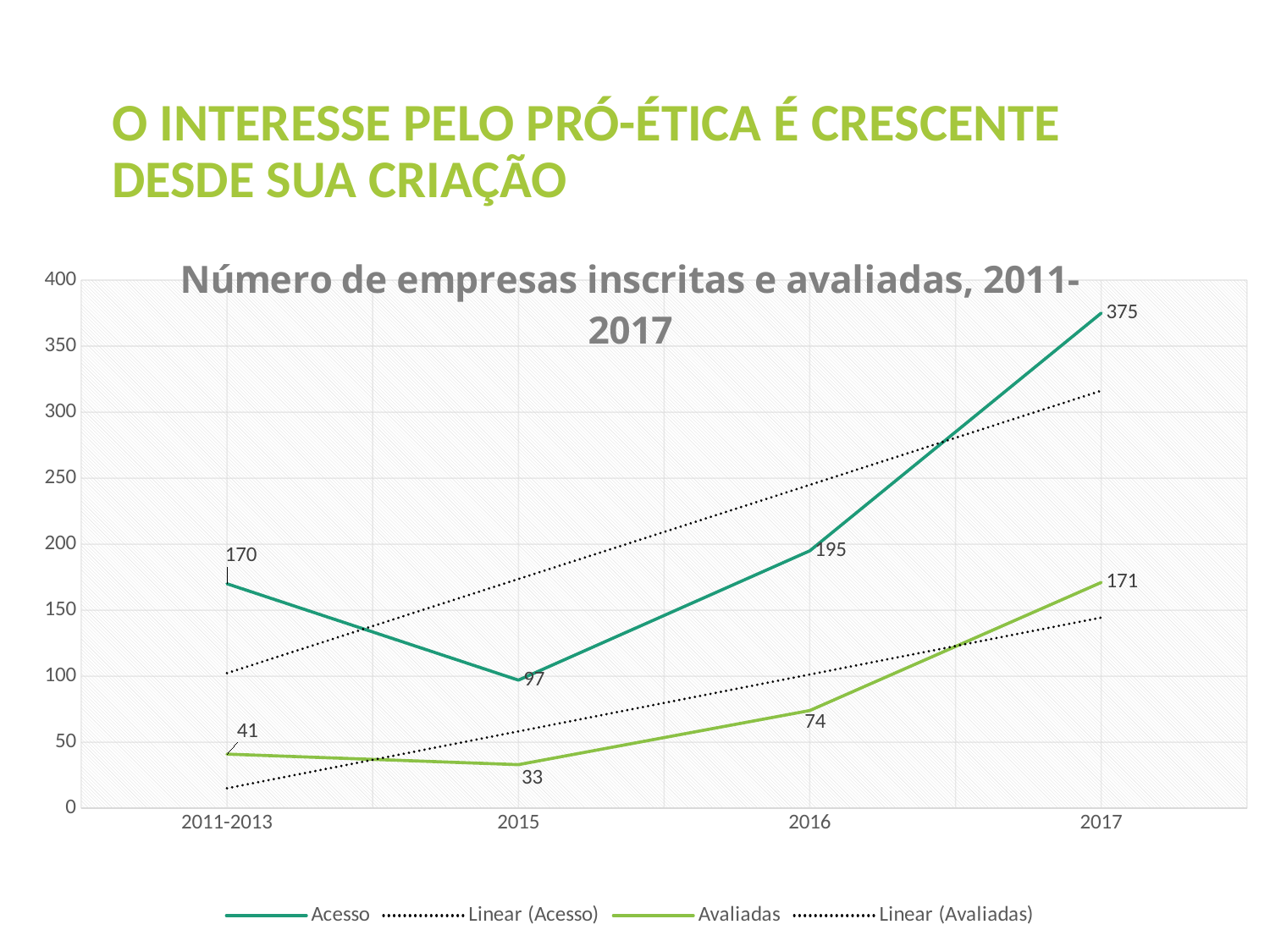
Which is larger, Acesso in 2011-2013 or Acesso in 2016? Acesso in 2016 What is the value of Avaliadas for 2016? 74 What is the difference between Acesso in 2016 and Acesso in 2015? 98 What is the value of Acesso for 2011-2013? 170 In which period is Avaliadas highest? 2017 What is the difference between Acesso and Avaliadas in 2017? 204 What is the value of Avaliadas for 2015? 33 How many entries does the legend list? 4 In which period is Acesso lowest? 2015 How many periods are shown on the x axis? 4 What kind of chart is shown? Line chart What is the value of Acesso for 2017? 375